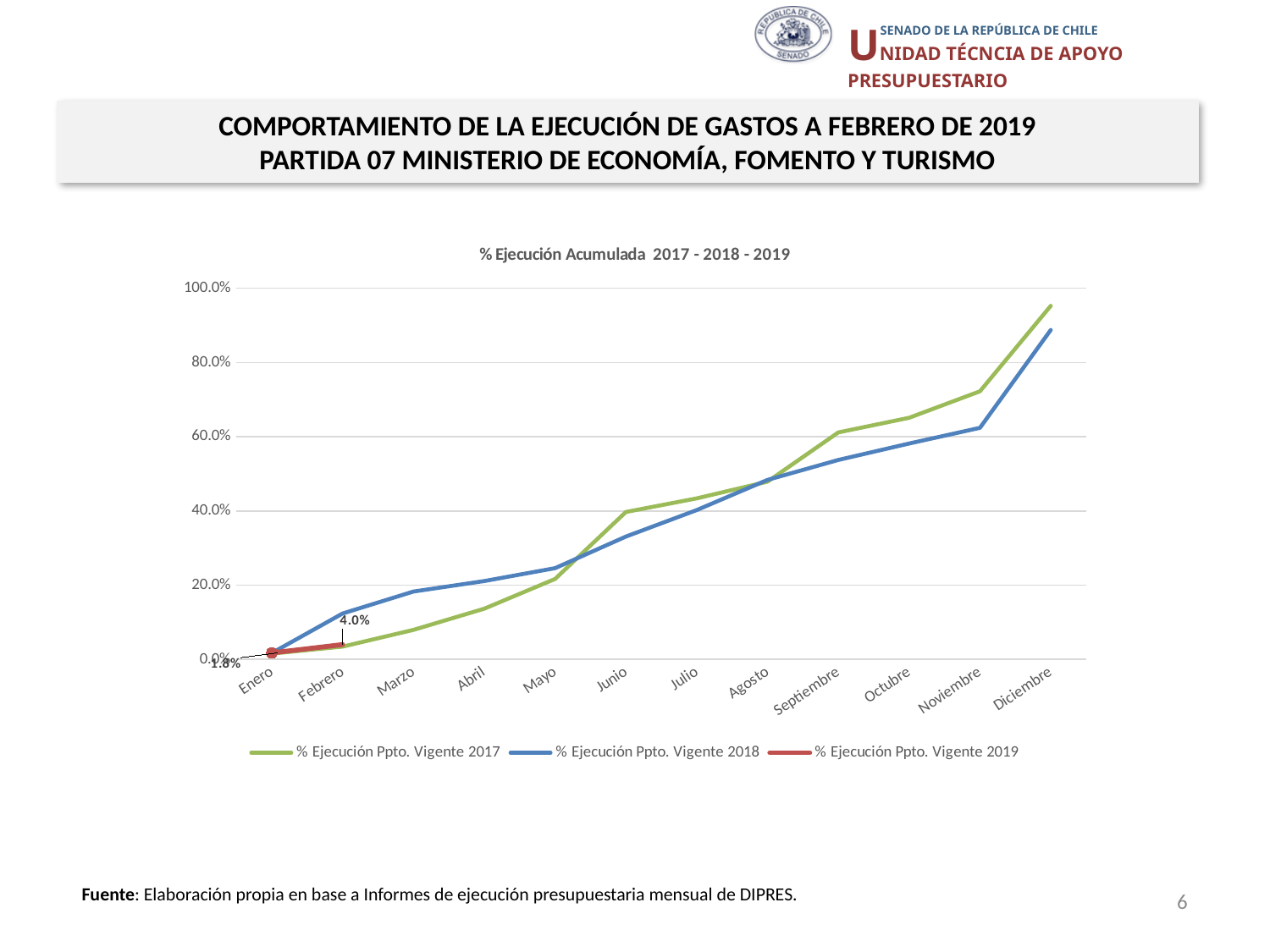
Is the value for % Ejecución Ppto. Vigente 2018 in Junio greater or less than 40.0%? less Is the value for % Ejecución Ppto. Vigente 2017 in Marzo greater or less than 20.0%? less What is the title of the chart? % Ejecución Acumulada 2017 - 2018 - 2019 Do the values for % Ejecución Ppto. Vigente 2018 rise or fall from Enero to Diciembre? rise How many series does the legend list? 3 Is the value for % Ejecución Ppto. Vigente 2017 in Noviembre greater or less than 80.0%? less What is the value for % Ejecución Ppto. Vigente 2019 in Febrero? 4.0% In Marzo, which series is higher: % Ejecución Ppto. Vigente 2017 or % Ejecución Ppto. Vigente 2018? % Ejecución Ppto. Vigente 2018 How many months are shown along the x axis? 12 What kind of chart is shown on the slide? line chart In Diciembre, which series is higher: % Ejecución Ppto. Vigente 2017 or % Ejecución Ppto. Vigente 2018? % Ejecución Ppto. Vigente 2017